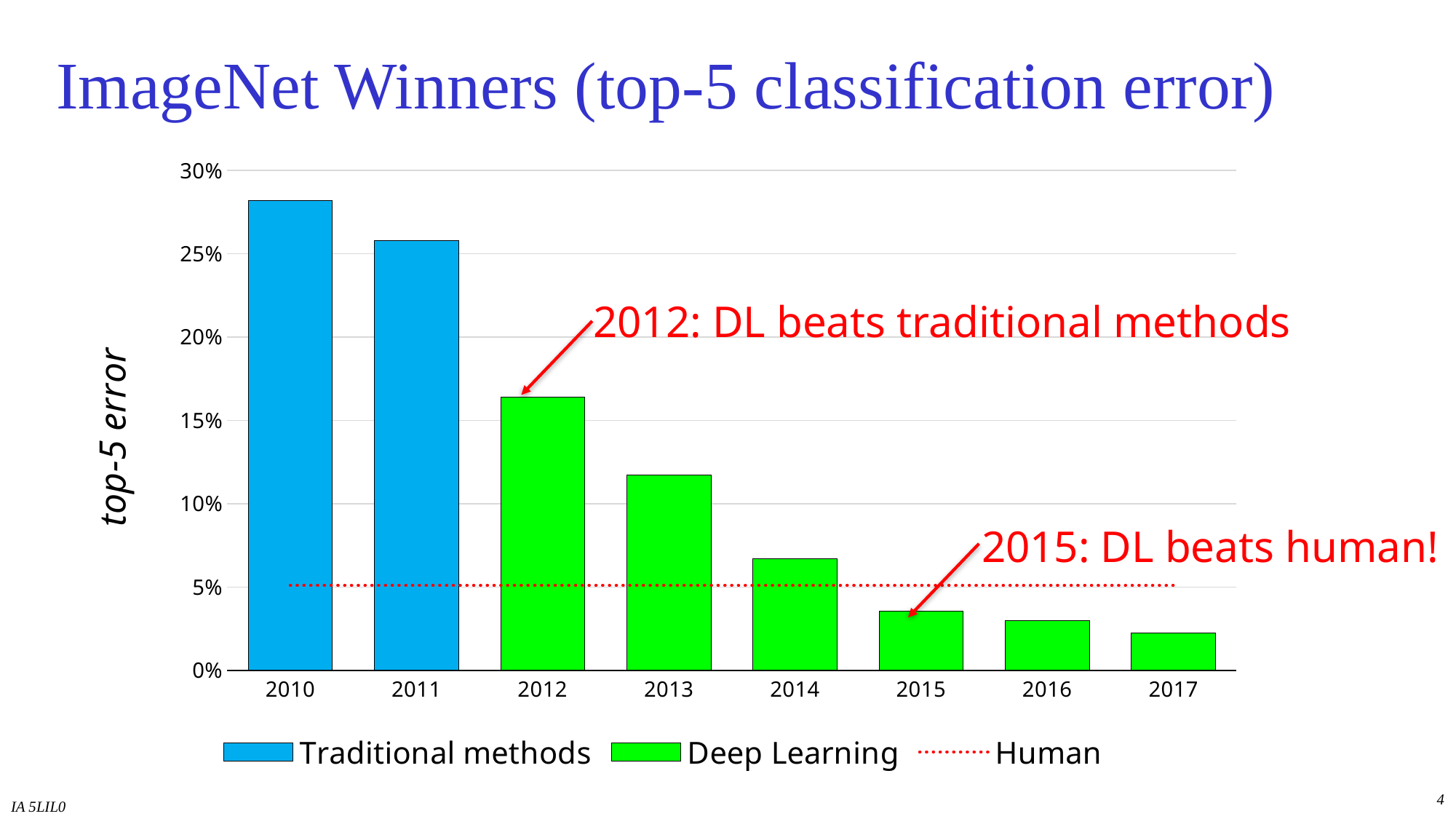
Which year has the larger top-5 error, 2012 or 2013? 2012 Is the top-5 error for 2012 greater or less than 15%? greater How many years are shown on the x axis of the chart? 8 Which year has the highest top-5 error in the chart? 2010 Is the top-5 error for 2010 greater or less than 25%? greater How many entries does the chart's legend list? 3 What kind of chart is shown on the slide? bar chart Which year has the lowest top-5 error in the chart? 2017 Which legend entry is shown as a dotted red line? Human Do the top-5 error values rise or fall from 2010 to 2017? fall Is the top-5 error for 2014 greater or less than 5%? greater